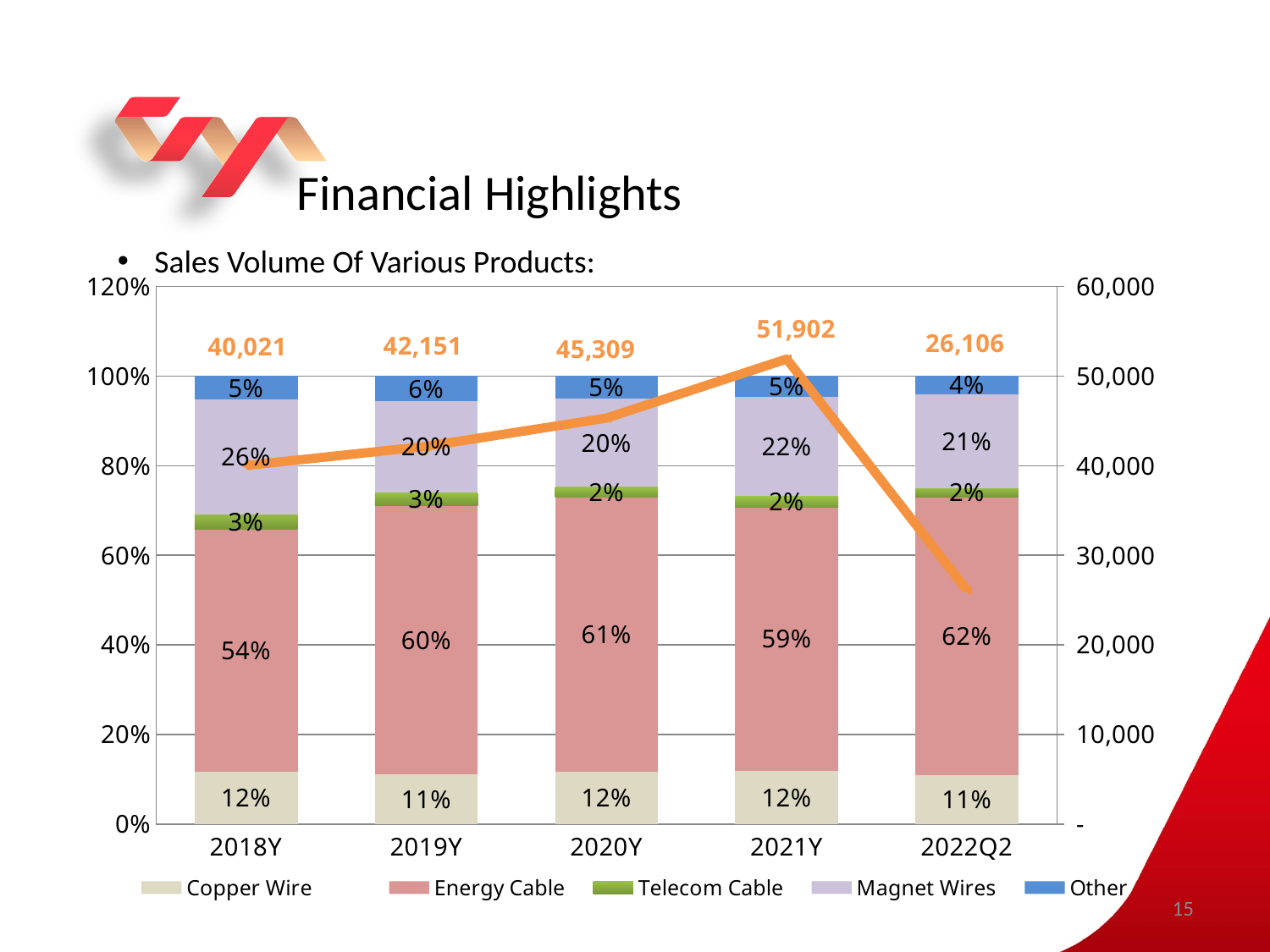
What is the Copper Wire share for 2019Y? 11% What is the Magnet Wires share for 2018Y? 26% Does the total sales volume line rise or fall from 2018Y to 2021Y? Rise Is the Energy Cable share larger in 2022Q2 or in 2018Y? 2022Q2 Which period has the lowest total sales volume labelled on the line? 2022Q2 How many periods are shown on the x axis? 5 What total sales volume is labelled on the line for 2021Y? 51,902 How many series does the legend list? 5 Which year has the highest total sales volume labelled on the line? 2021Y What kind of chart is used for the product shares? Stacked bar chart What is the Energy Cable share for 2020Y? 61% What is the difference between the total sales volume for 2021Y and 2020Y? 6,593